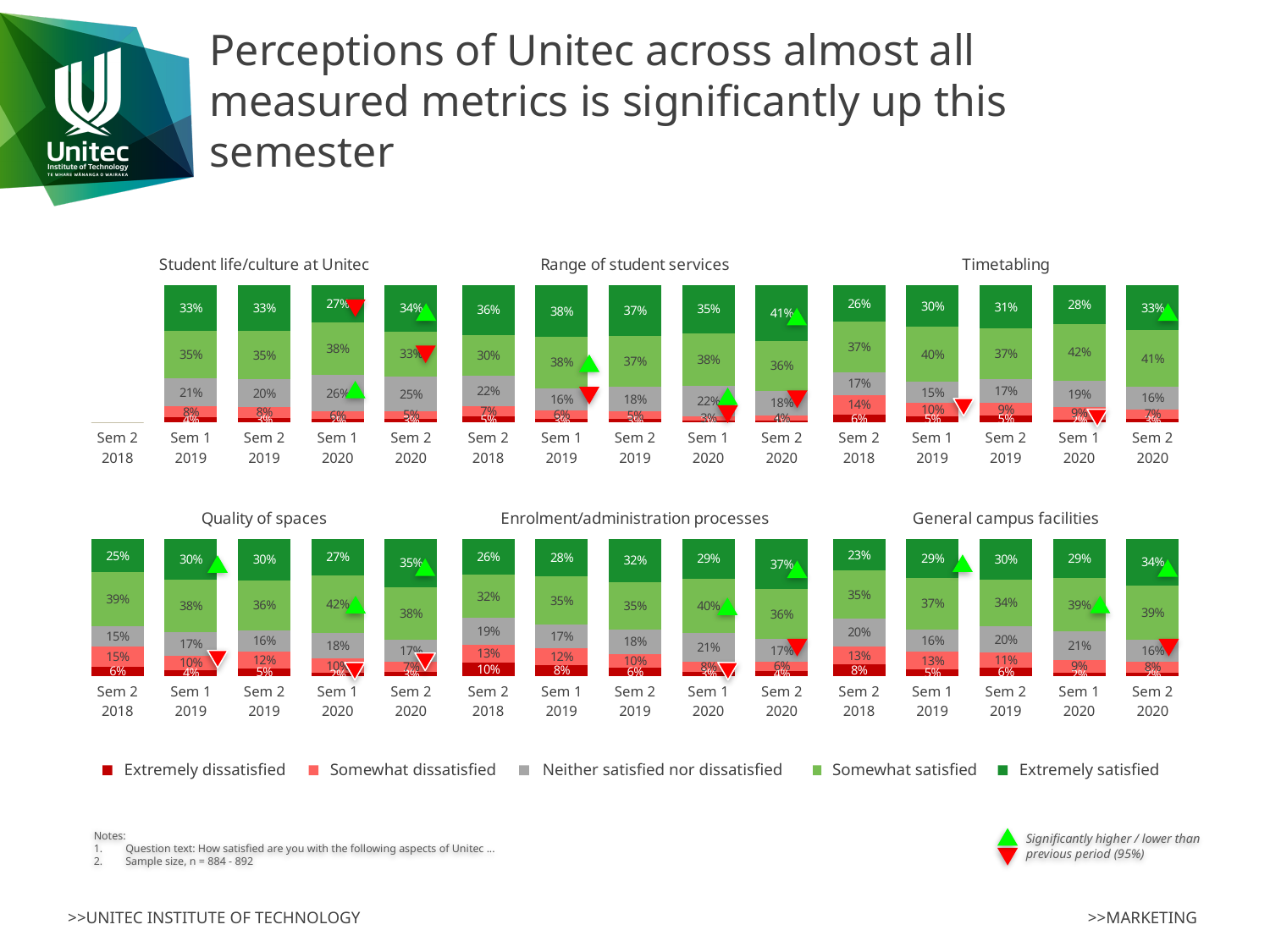
In the Timetabling chart, what percentage were Somewhat satisfied in Sem 2 2020? 41% In the Quality of spaces chart, what percentage were Extremely satisfied in Sem 2 2020? 35% How many series does the legend list? 5 In the General campus facilities chart, which semester has the larger Somewhat satisfied percentage, Sem 2 2019 or Sem 1 2020? Sem 1 2020 How many charts are shown on the slide? 6 In the Enrolment/administration processes chart, by how many percentage points did Extremely satisfied increase from Sem 2 2018 to Sem 2 2020? 11 percentage points In the Quality of spaces chart, which semester has the highest Extremely satisfied percentage? Sem 2 2020 How many semesters are shown on the x axis of the Quality of spaces chart? 5 What kind of chart is used for Enrolment/administration processes? Stacked bar chart In the Enrolment/administration processes chart, what percentage were Extremely dissatisfied in Sem 2 2018? 10% In the General campus facilities chart, what percentage were Extremely satisfied in Sem 2 2018? 23% In the Enrolment/administration processes chart, what percentage were Somewhat satisfied in Sem 1 2020? 40%